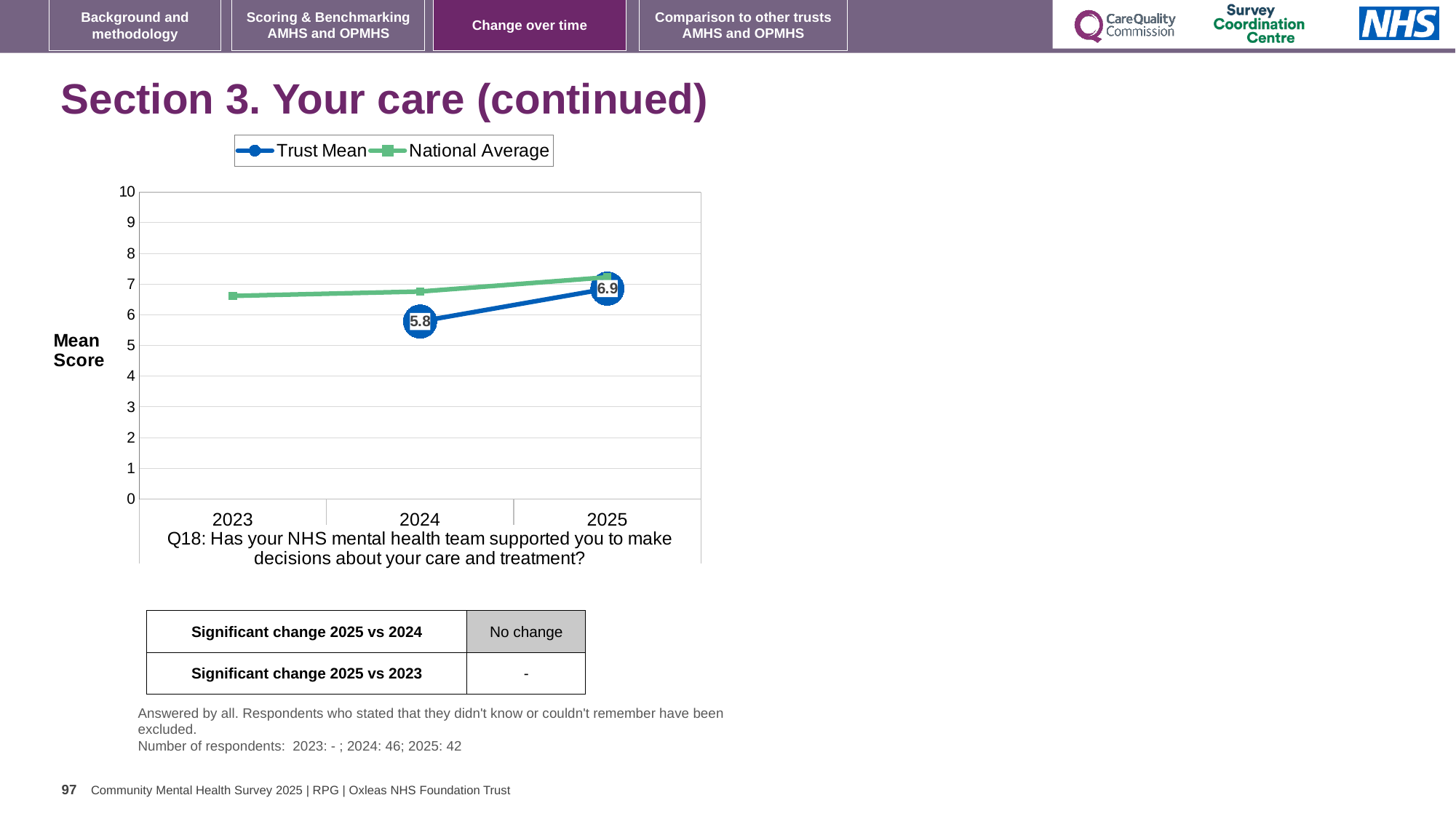
What kind of chart is shown on the slide? line chart What is the label on the y axis of the chart? Mean Score How many series does the legend list? 2 Is the National Average value for 2023 greater or less than 6? greater What is the Trust Mean value for 2025? 6.9 Is the National Average value for 2023 greater or less than 7? less By how much did the Trust Mean change from 2024 to 2025? 1.1 How many years are shown on the x axis? 3 What is the Trust Mean value for 2024? 5.8 Which year has the higher Trust Mean, 2024 or 2025? 2025 In 2024, which is higher: the Trust Mean or the National Average? National Average Does the Trust Mean rise or fall from 2024 to 2025? rise